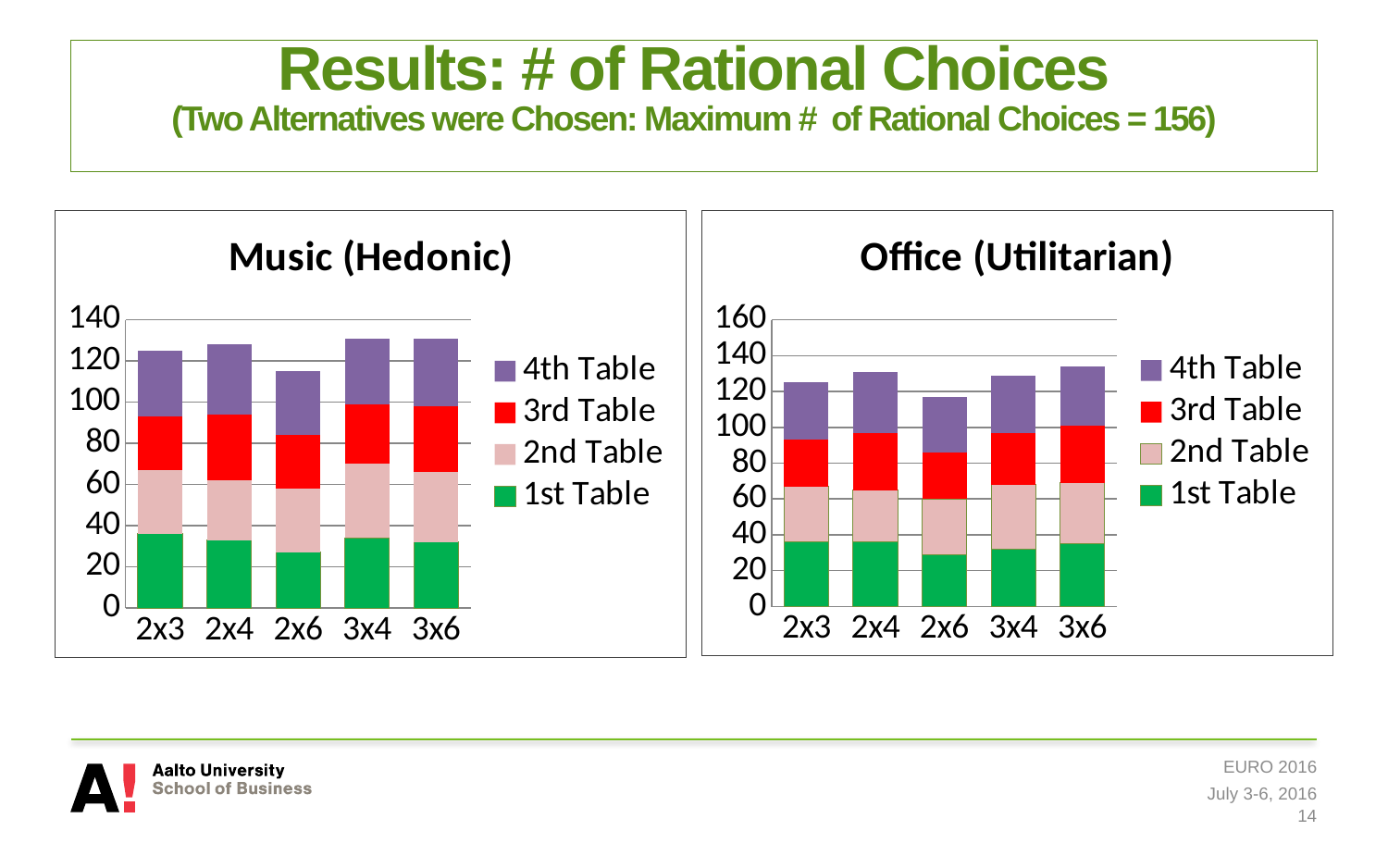
In the Office (Utilitarian) chart, which series is shown in green? 1st Table In the Office (Utilitarian) chart, is the total for 3x6 greater or less than 120? greater How many categories are shown on the x axis of the Office (Utilitarian) chart? 5 In the Music (Hedonic) chart, which category has the lowest total bar? 2x6 In the Music (Hedonic) chart, is the total for 3x4 greater or less than 120? greater In the Office (Utilitarian) chart, which has the larger total bar, 2x6 or 3x6? 3x6 In the Office (Utilitarian) chart, which category has the lowest total bar? 2x6 What is the title of the chart on the right side of the slide? Office (Utilitarian) What type of chart is the Music (Hedonic) chart? stacked bar chart In the Music (Hedonic) chart, which has the larger total bar, 2x3 or 2x6? 2x3 In the Music (Hedonic) chart, is the total for 2x6 greater or less than 120? less How many series does the legend of the Music (Hedonic) chart list? 4